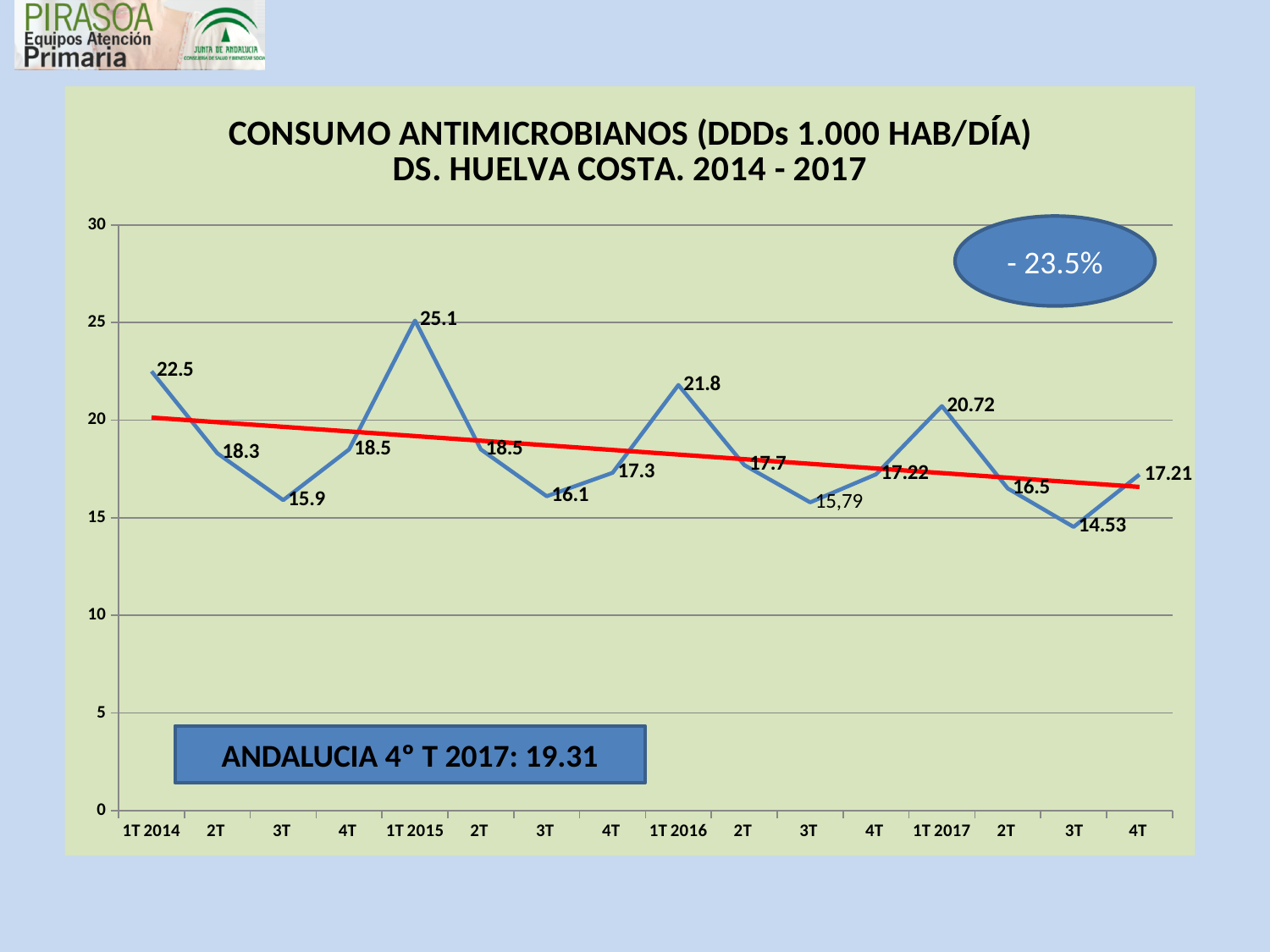
Which quarter has the lowest value? 3T 2017 What is the difference between the values for 1T 2015 and 3T 2017? 10.57 What is the value for 4T 2017? 17.21 Which quarter has the highest value? 1T 2015 What is the value for 3T 2017? 14.53 What percentage change is shown in the blue oval on the chart? - 23.5% What type of chart is shown on the slide? line chart How many quarterly data points are plotted on the chart? 16 Does the red trend line rise or fall from left to right? fall What is the value for 1T 2015? 25.1 What is the value for 1T 2014? 22.5 Which is larger, the value for 1T 2016 or the value for 1T 2017? 1T 2016